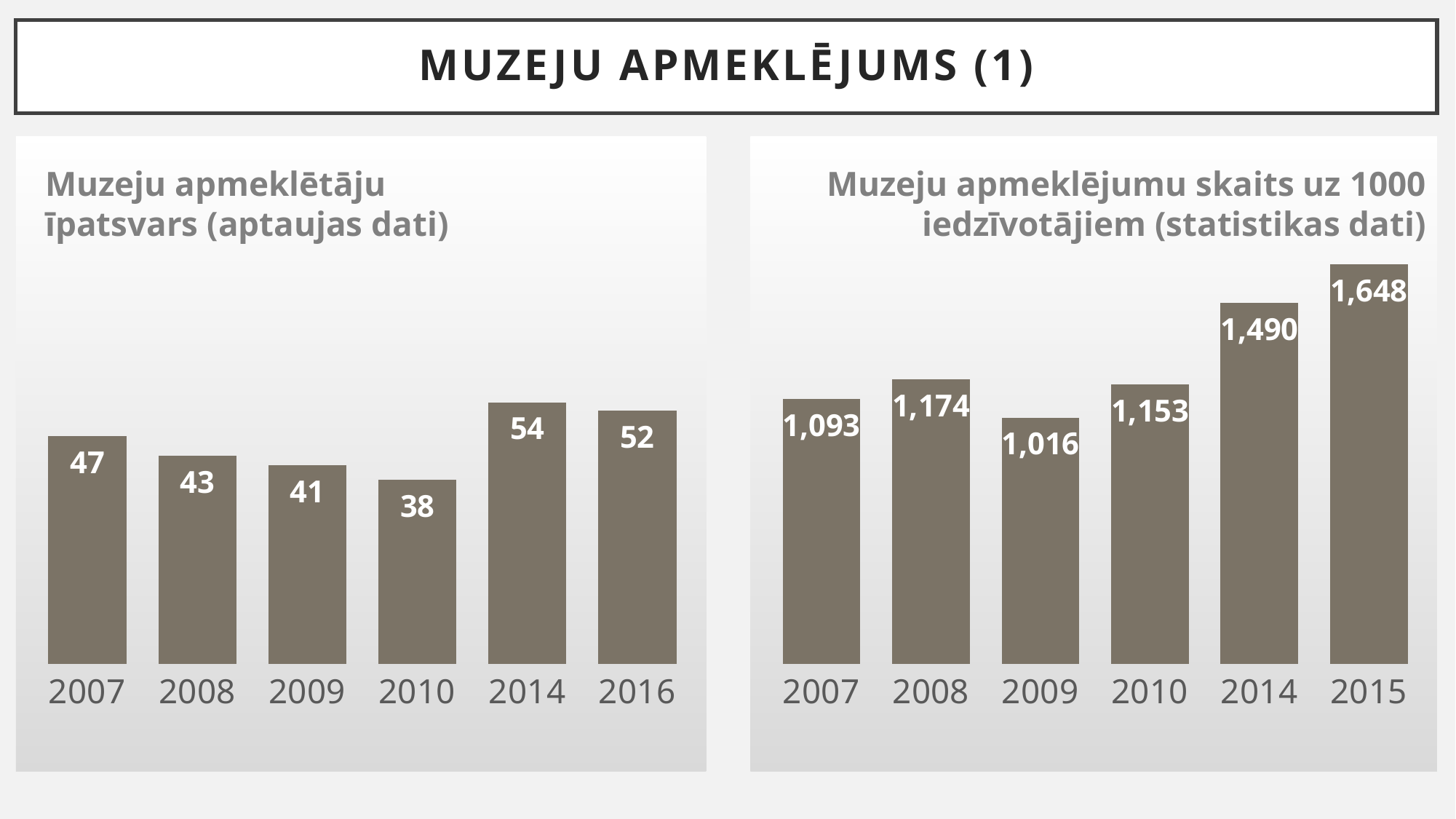
In the left chart (Muzeju apmeklētāju īpatsvars), how many years are shown? 6 What is the last year shown on the x axis of the right chart (Muzeju apmeklējumu skaits uz 1000 iedzīvotājiem)? 2015 In the right chart (Muzeju apmeklējumu skaits uz 1000 iedzīvotājiem), which year has the lowest value? 2009 In the right chart (Muzeju apmeklējumu skaits uz 1000 iedzīvotājiem), what is the value for 2008? 1,174 What type of chart is the right chart (Muzeju apmeklējumu skaits uz 1000 iedzīvotājiem)? Bar chart In the left chart (Muzeju apmeklētāju īpatsvars), what is the difference between the values for 2014 and 2007? 7 In the right chart (Muzeju apmeklējumu skaits uz 1000 iedzīvotājiem), which is larger, the value for 2007 or the value for 2010? 2010 In the left chart (Muzeju apmeklētāju īpatsvars), which year has the lowest value? 2010 In the right chart (Muzeju apmeklējumu skaits uz 1000 iedzīvotājiem), what is the difference between the values for 2015 and 2014? 158 In the right chart (Muzeju apmeklējumu skaits uz 1000 iedzīvotājiem), which year has the highest value? 2015 In the left chart (Muzeju apmeklētāju īpatsvars), which year has the highest value? 2014 In the left chart (Muzeju apmeklētāju īpatsvars), what is the value for 2010? 38